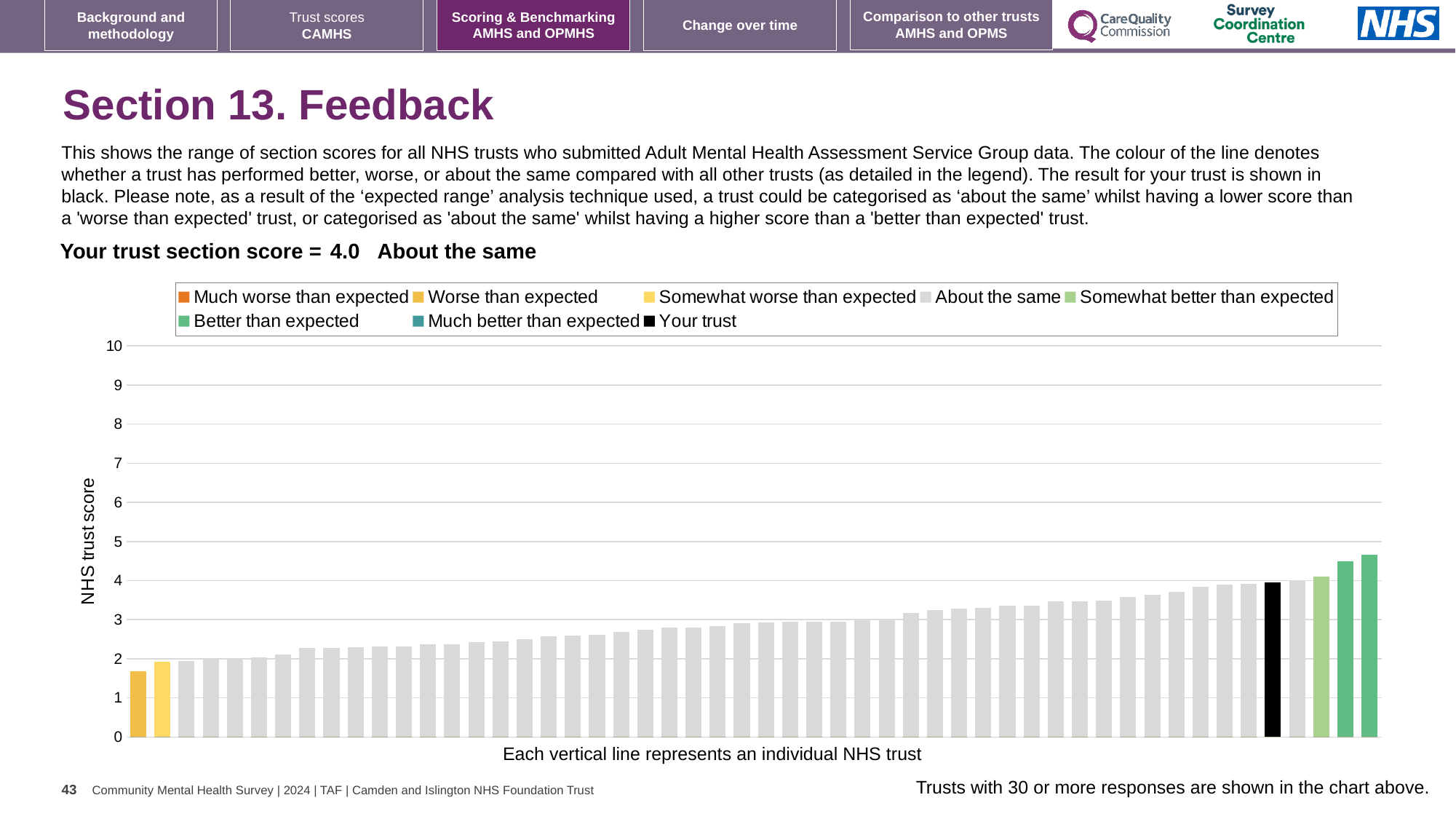
Is the value of the leftmost bar greater or less than 2? less Is the value of the black 'Your trust' bar greater or less than 5? less Is the value of the tallest bar greater or less than 4? greater What is the title of the vertical axis? NHS trust score What is the section score for your trust? 4.0 Which legend category does the tallest bar belong to? Better than expected What kind of chart is shown on the slide? bar chart How many categories does the chart legend list? 8 Do the bar values rise or fall from left to right along the x axis? rise What colour is used for the 'Your trust' bar? black Which category is your trust's section score placed in? About the same